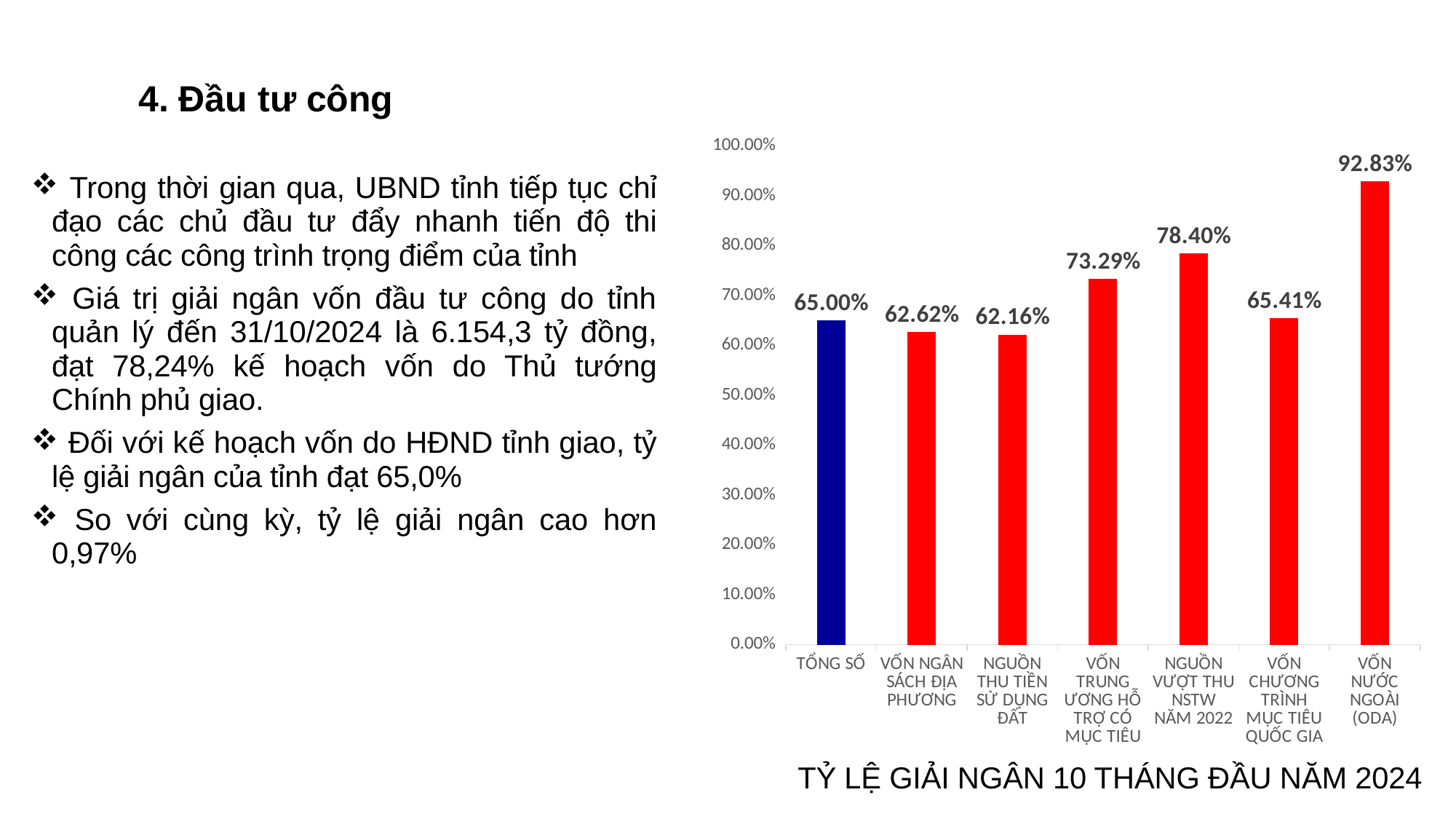
What is the title of the chart? TỶ LỆ GIẢI NGÂN 10 THÁNG ĐẦU NĂM 2024 Which is larger, the value for NGUỒN VƯỢT THU NSTW NĂM 2022 or the value for VỐN CHƯƠNG TRÌNH MỤC TIÊU QUỐC GIA? NGUỒN VƯỢT THU NSTW NĂM 2022 Is the value for VỐN NGÂN SÁCH ĐỊA PHƯƠNG greater or less than 70.00%? less Which category has the highest value? VỐN NƯỚC NGOÀI (ODA) What is the value for NGUỒN VƯỢT THU NSTW NĂM 2022? 78.40% What is the difference between the values for VỐN NƯỚC NGOÀI (ODA) and TỔNG SỐ? 27.83% What is the value for TỔNG SỐ? 65.00% What is the value for VỐN TRUNG ƯƠNG HỖ TRỢ CÓ MỤC TIÊU? 73.29% How many categories are shown on the x axis? 7 What kind of chart is shown on the slide? bar chart What is the value for VỐN NƯỚC NGOÀI (ODA)? 92.83% Which category has the lowest value? NGUỒN THU TIỀN SỬ DỤNG ĐẤT